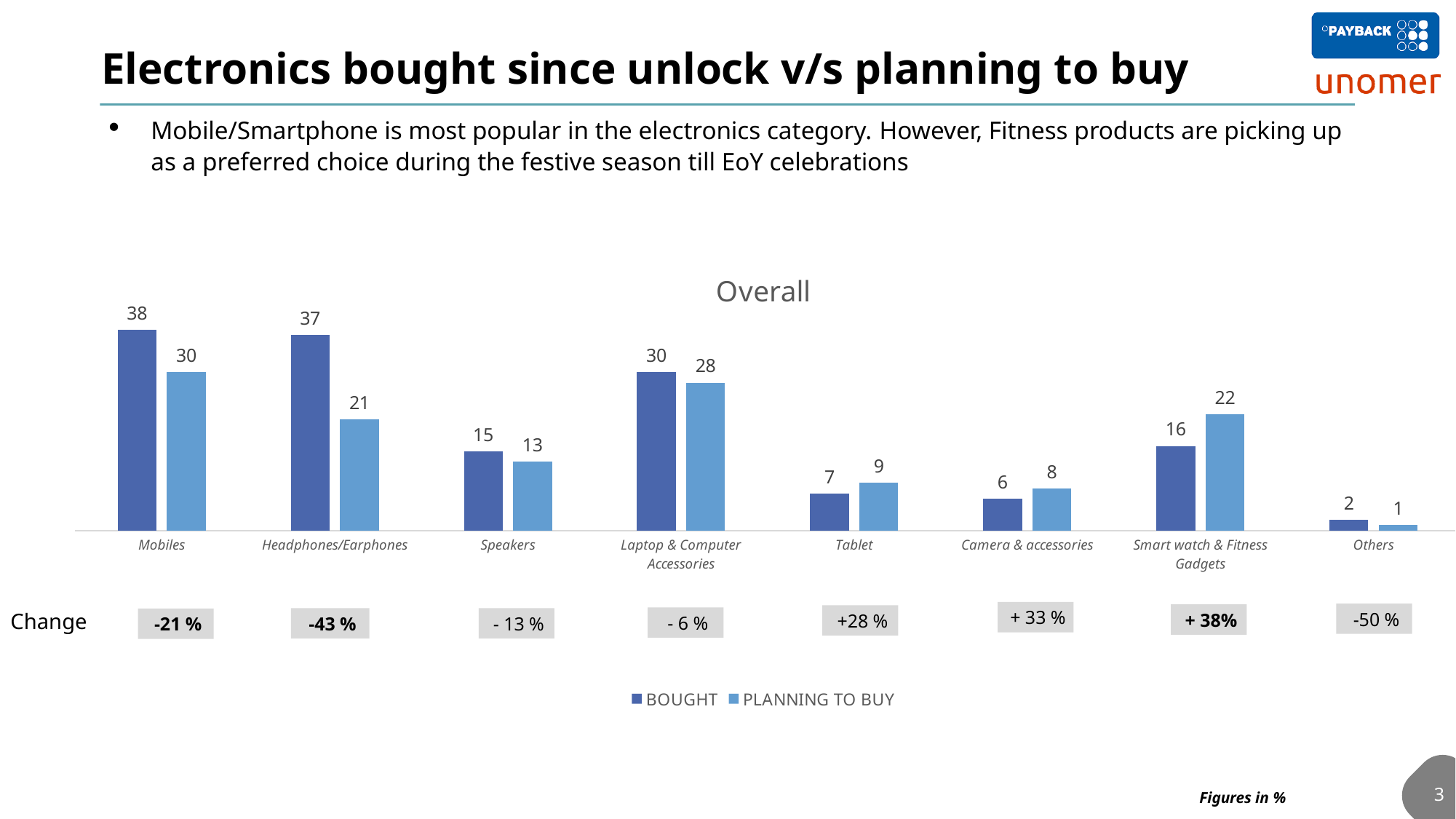
How many categories are shown on the x axis? 8 Which category has the highest BOUGHT value? Mobiles What is the PLANNING TO BUY value for Smart watch & Fitness Gadgets? 22 What is the difference between the BOUGHT and PLANNING TO BUY values for Headphones/Earphones? 16 What kind of chart is shown on the slide? Bar chart For Tablet, which is larger: BOUGHT or PLANNING TO BUY? PLANNING TO BUY What is the BOUGHT value for Mobiles? 38 How many series does the legend list? 2 Which category has the lowest PLANNING TO BUY value? Others What is the PLANNING TO BUY value for Headphones/Earphones? 21 What is the title of the chart? Overall What is the BOUGHT value for Laptop & Computer Accessories? 30